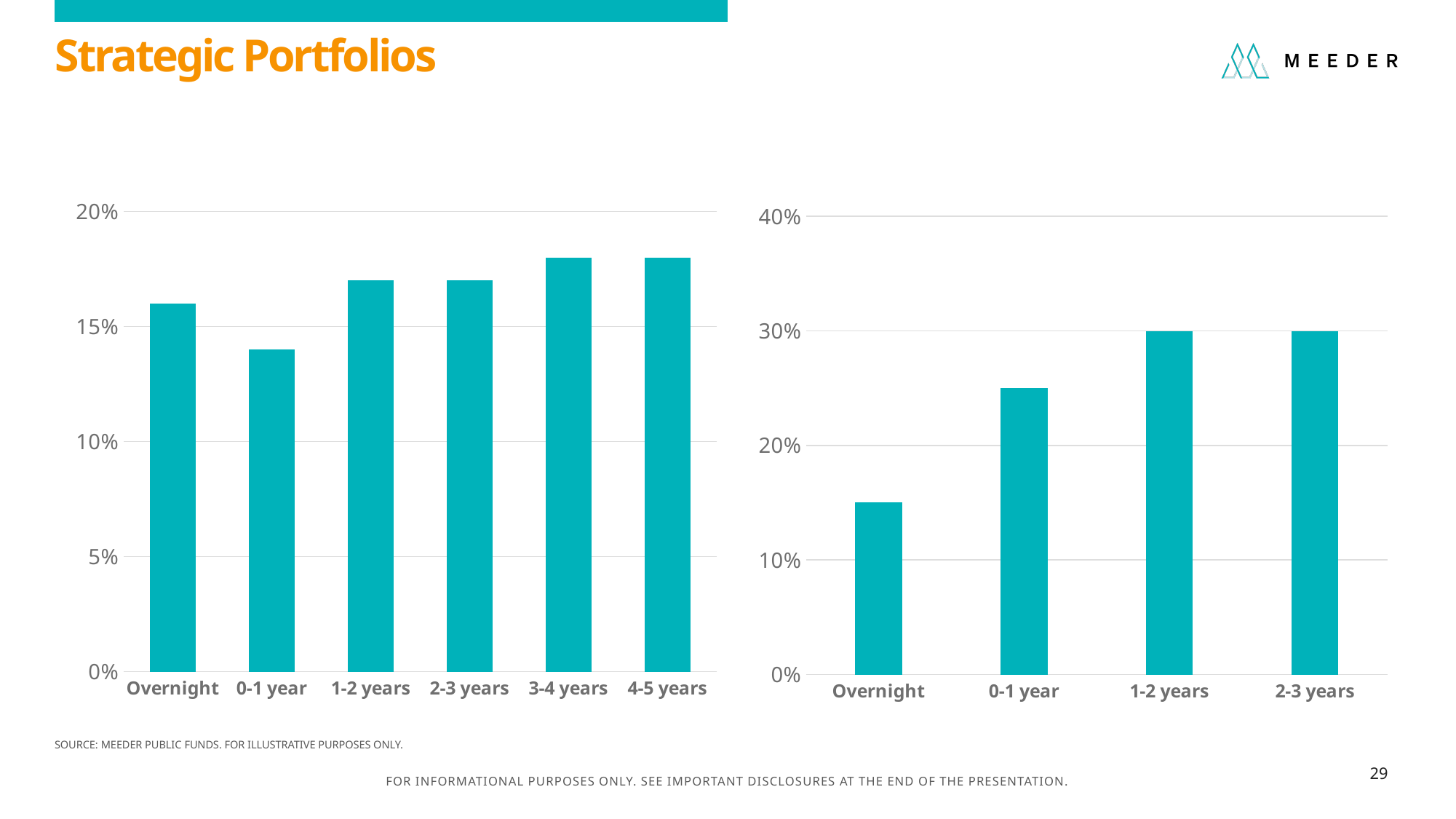
In the right chart, what is the value for 1-2 years? 30% In the right chart, do the values rise or fall from Overnight to 1-2 years? Rise In the left chart, which category has the lowest value? 0-1 year In the left chart, is the value for 0-1 year greater or less than 15%? less In the left chart, is the value for Overnight greater or less than 15%? greater How many categories are shown on the x axis of the right chart? 4 In the right chart, which category has the lowest value? Overnight What kind of chart is the left chart on the slide? Bar chart How many categories are shown on the x axis of the left chart? 6 In the right chart, is the value for Overnight greater or less than 20%? less In the left chart, which is larger, the value for Overnight or the value for 0-1 year? Overnight